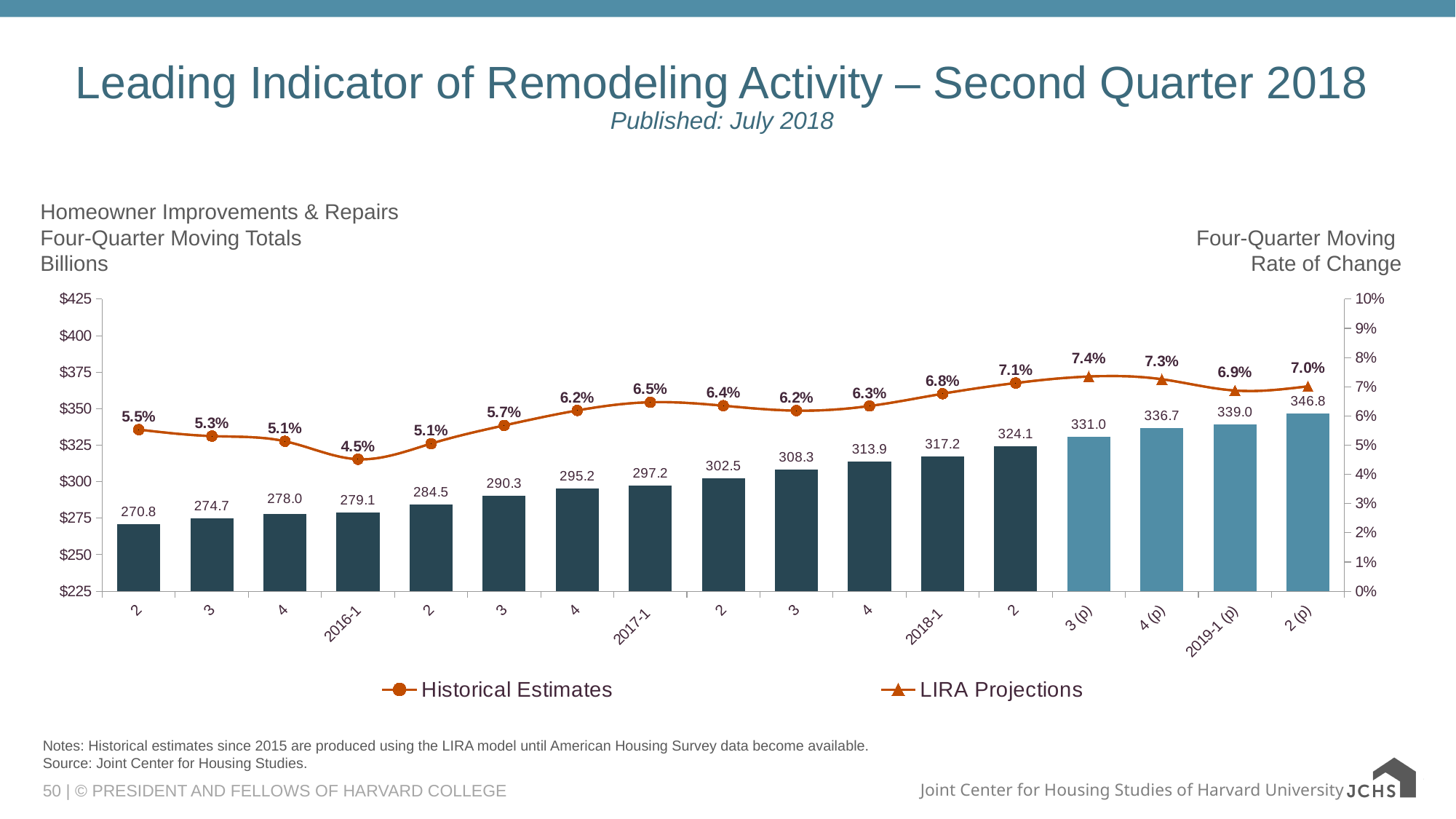
Do the four-quarter moving totals (bars) rise or fall from left to right across the chart? rise What is the four-quarter moving rate of change shown for 2016-1? 4.5% What is the four-quarter moving total (in billions) shown for 2018-1? 317.2 What is the rate of change shown for 3 (p)? 7.4% What are the two series named in the legend? Historical Estimates and LIRA Projections Which has the higher four-quarter moving total, 2017-1 or 2016-1? 2017-1 How many periods (bars) are shown on the x axis? 17 What is the four-quarter moving total shown for 2 (p), the last bar on the chart? 346.8 What is the difference between the four-quarter moving totals for 2019-1 (p) and 2018-1? 21.8 Which period has the highest four-quarter moving rate of change on the line? 3 (p) Which period has the lowest four-quarter moving rate of change on the line? 2016-1 How many series does the legend list? 2